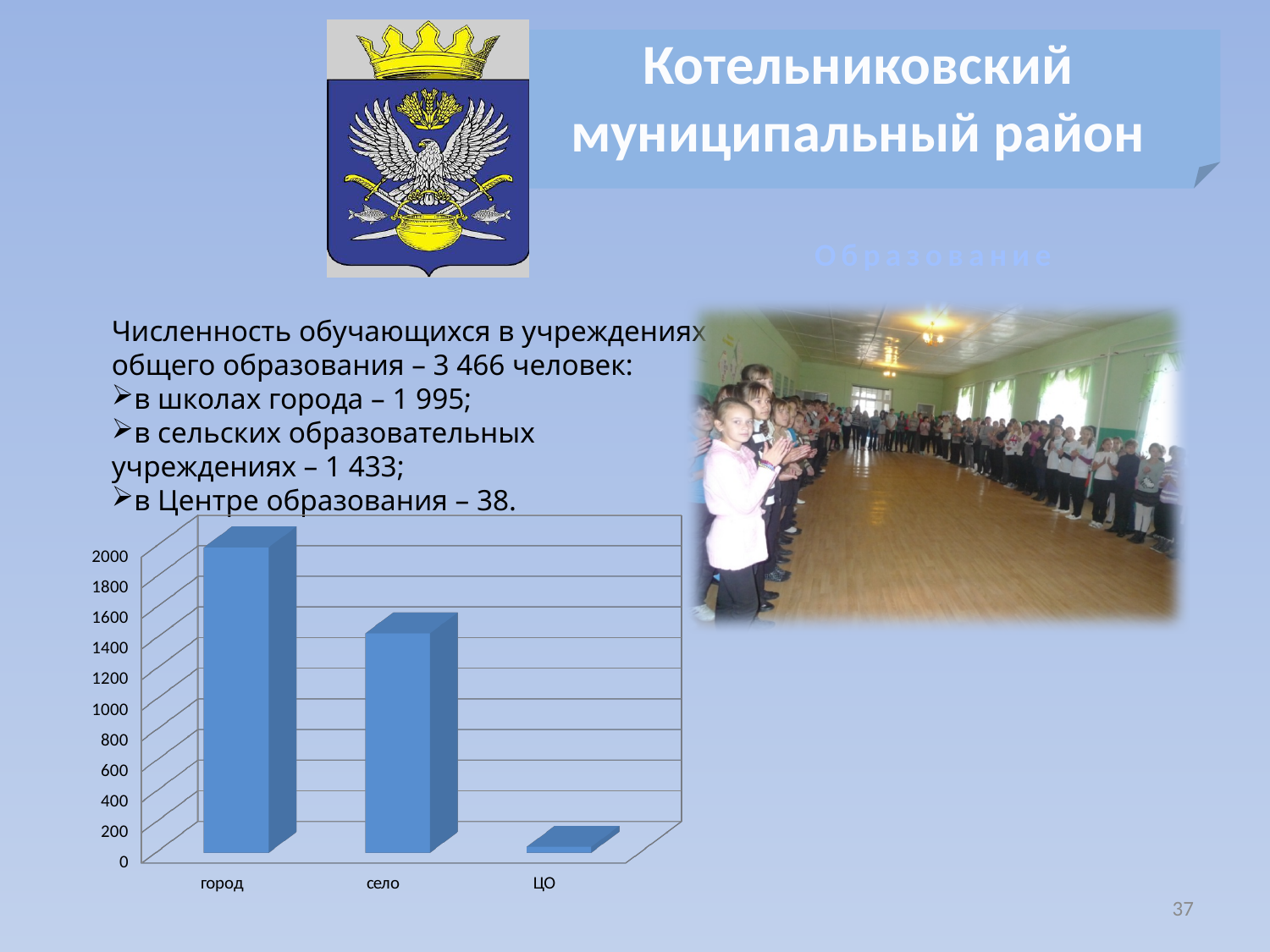
Which category has the highest bar in the chart? город Is the value for село greater or less than 1200? greater Is the value for ЦО greater or less than 200? less What is the label of the middle category on the x axis? село What is the highest tick value shown on the vertical axis of the chart? 2000 How many categories are shown on the x axis of the chart? 3 Is the value for город greater or less than 1800? greater Which is larger, the bar for город or the bar for село? город Which category has the lowest bar in the chart? ЦО What kind of chart is shown on the slide? bar chart Do the bar values rise or fall from left to right along the x axis? fall